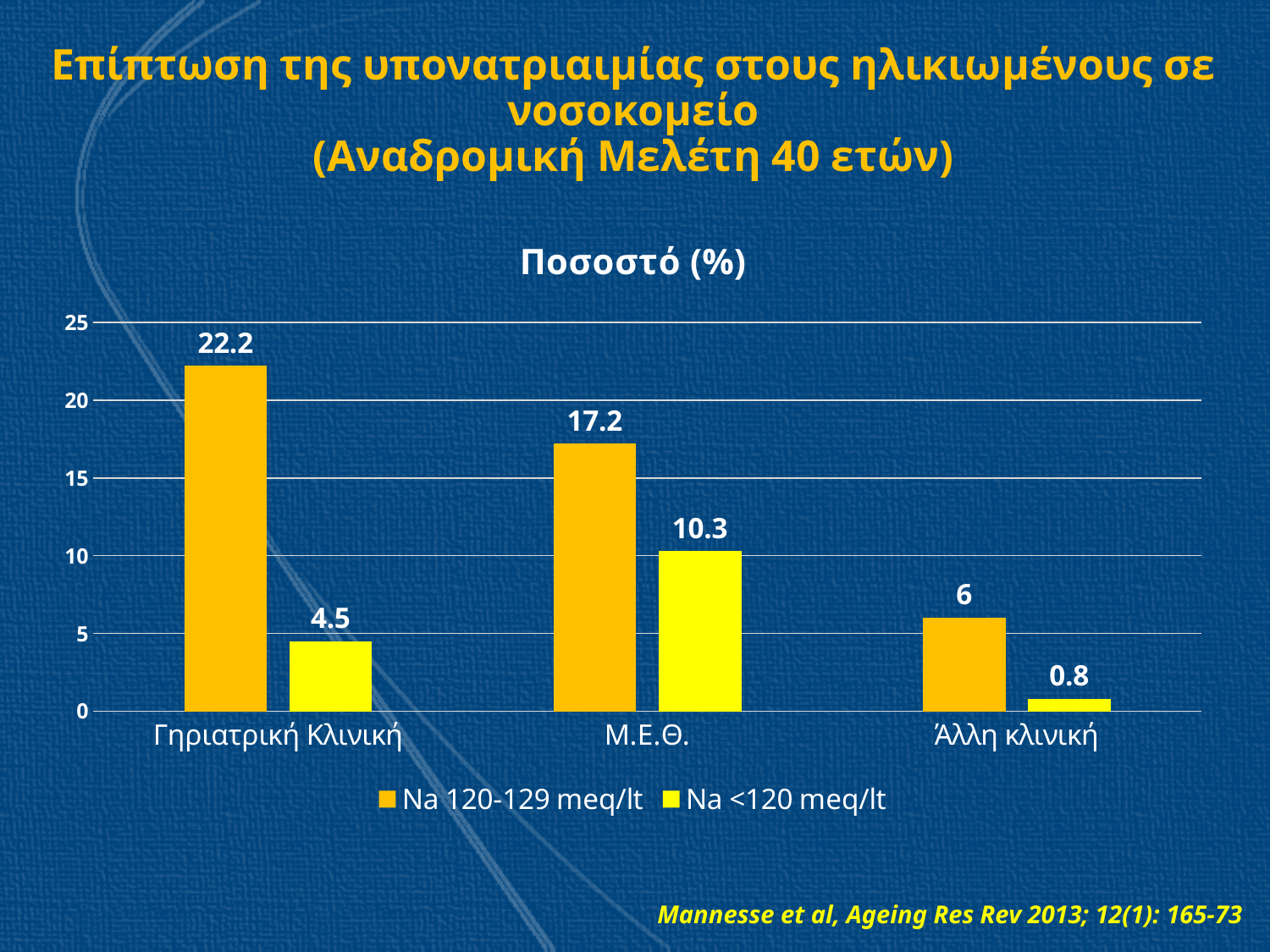
What is the value for Na <120 meq/lt in Μ.Ε.Θ.? 10.3 Is the value for Na 120-129 meq/lt in Μ.Ε.Θ. greater or less than 15? greater What is the value for Na <120 meq/lt in Άλλη κλινική? 0.8 What kind of chart is shown on the slide? bar chart What is the value for Na 120-129 meq/lt in Γηριατρική Κλινική? 22.2 How many categories are shown on the x axis? 3 How many series does the legend list? 2 Which is larger: the Na <120 meq/lt value in Γηριατρική Κλινική or the Na 120-129 meq/lt value in Άλλη κλινική? Na 120-129 meq/lt in Άλλη κλινική Which category has the lowest value for Na <120 meq/lt? Άλλη κλινική What is the difference between the Na 120-129 meq/lt and Na <120 meq/lt values in Μ.Ε.Θ.? 6.9 Which category has the highest value for Na 120-129 meq/lt? Γηριατρική Κλινική What is the title of the chart? Ποσοστό (%)